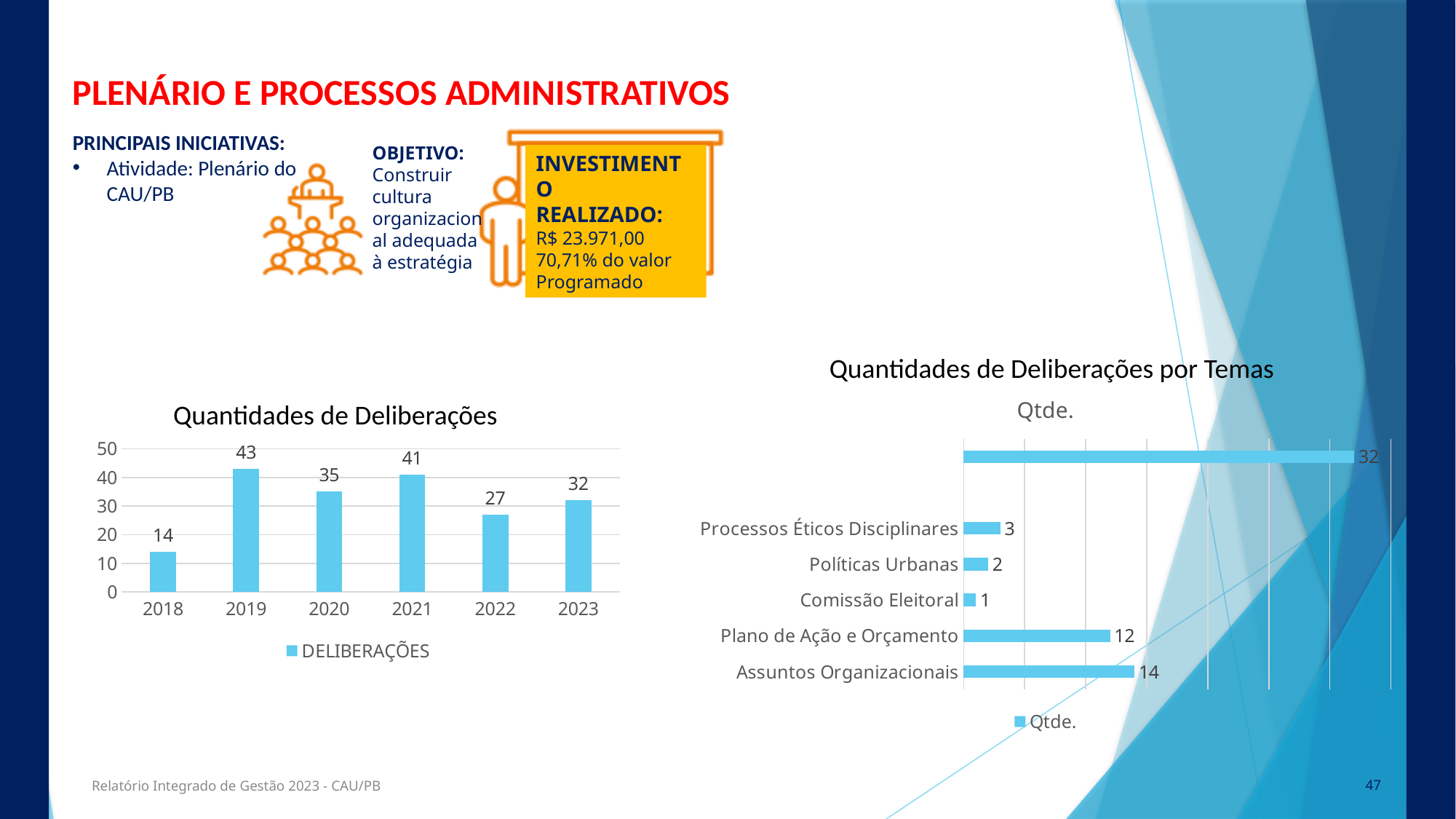
In the 'Quantidades de Deliberações' chart, what is the difference between the values for 2021 and 2022? 14 What type of chart is 'Quantidades de Deliberações'? Bar chart In the 'Quantidades de Deliberações' chart, which year has the highest value? 2019 In the 'Quantidades de Deliberações por Temas' chart, what is the value for Comissão Eleitoral? 1 In the 'Quantidades de Deliberações por Temas' chart, what is the value for Plano de Ação e Orçamento? 12 In the 'Quantidades de Deliberações' chart, which is larger, the value for 2020 or the value for 2023? 2020 In the 'Quantidades de Deliberações' chart, which year has the lowest value? 2018 In the 'Quantidades de Deliberações' chart, what is the value for 2019? 43 How many years are shown in the 'Quantidades de Deliberações' chart? 6 What series name appears in the legend of the 'Quantidades de Deliberações por Temas' chart? Qtde. In the 'Quantidades de Deliberações' chart, what is the value for 2023? 32 In the 'Quantidades de Deliberações por Temas' chart, what is the difference between Assuntos Organizacionais and Processos Éticos Disciplinares? 11